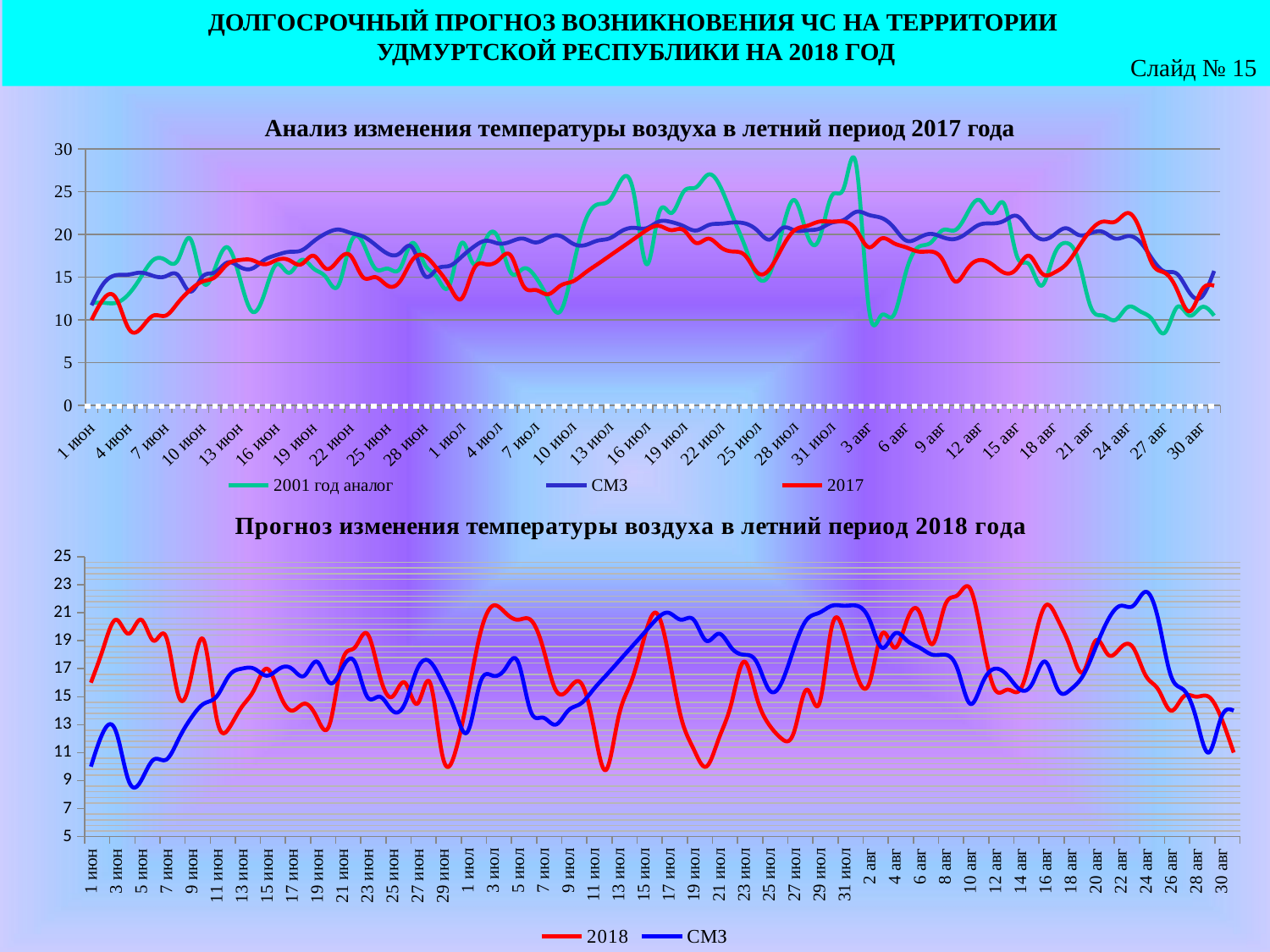
In the bottom chart (2018 года), is the value of the "2018" series around 10 авг greater or less than 21? greater In the top chart (2017 года), is the value of the "2017" series around 24 авг greater or less than 20? greater What kind of chart is the top chart titled "Анализ изменения температуры воздуха в летний период 2017 года"? line chart In the bottom chart (2018 года), is the value of the "СМЗ" series at 1 июн greater or less than 13? less What are the legend entries of the top chart (2017 года)? 2001 год аналог, СМЗ, 2017 How many series does the legend of the top chart (2017 года) list? 3 What is the title of the bottom chart? Прогноз изменения температуры воздуха в летний период 2018 года How many series does the legend of the bottom chart (2018 года) list? 2 In the top chart (2017 года), which series reaches the highest value on the chart? 2001 год аналог